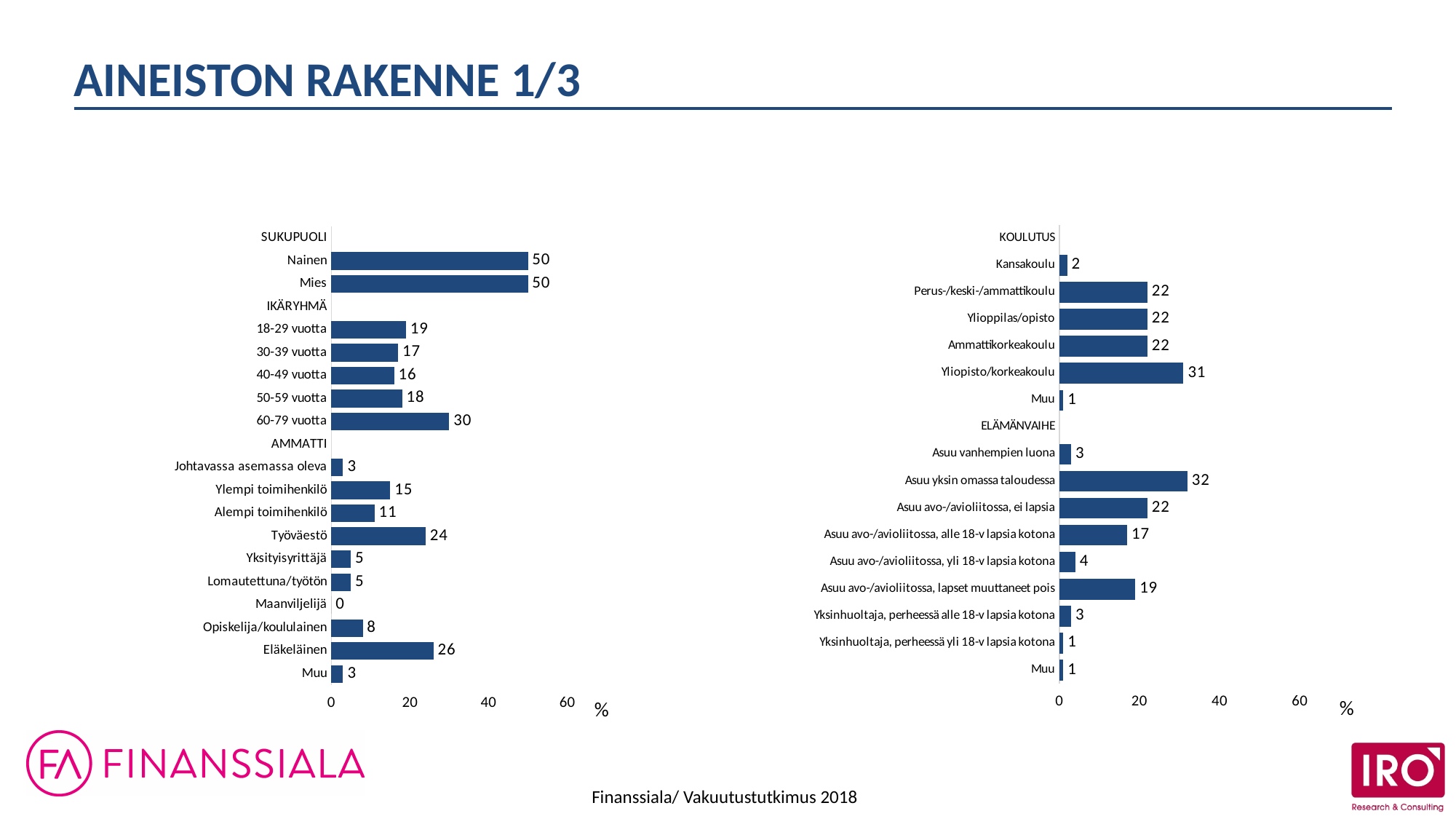
In the left chart, what is the difference between the values for Eläkeläinen and Opiskelija/koululainen? 18 What type of chart is shown on the left side of the slide? Bar chart In the right chart, what is the difference between the values for Asuu yksin omassa taloudessa and Asuu vanhempien luona? 29 In the left chart, what is the value for Työväestö? 24 In the left chart, what is the value for 60-79 vuotta? 30 In the right chart, how many KOULUTUS categories are plotted? 6 In the left chart, which age group (IKÄRYHMÄ) has the highest value? 60-79 vuotta In the right chart, what is the value for Asuu avo-/avioliitossa, lapset muuttaneet pois? 19 In the right chart, which is larger, the value for Yliopisto/korkeakoulu or the value for Ammattikorkeakoulu? Yliopisto/korkeakoulu In the right chart, what is the value for Yliopisto/korkeakoulu? 31 In the left chart, which AMMATTI category has the lowest value? Maanviljelijä In the right chart, which ELÄMÄNVAIHE category has the highest value? Asuu yksin omassa taloudessa